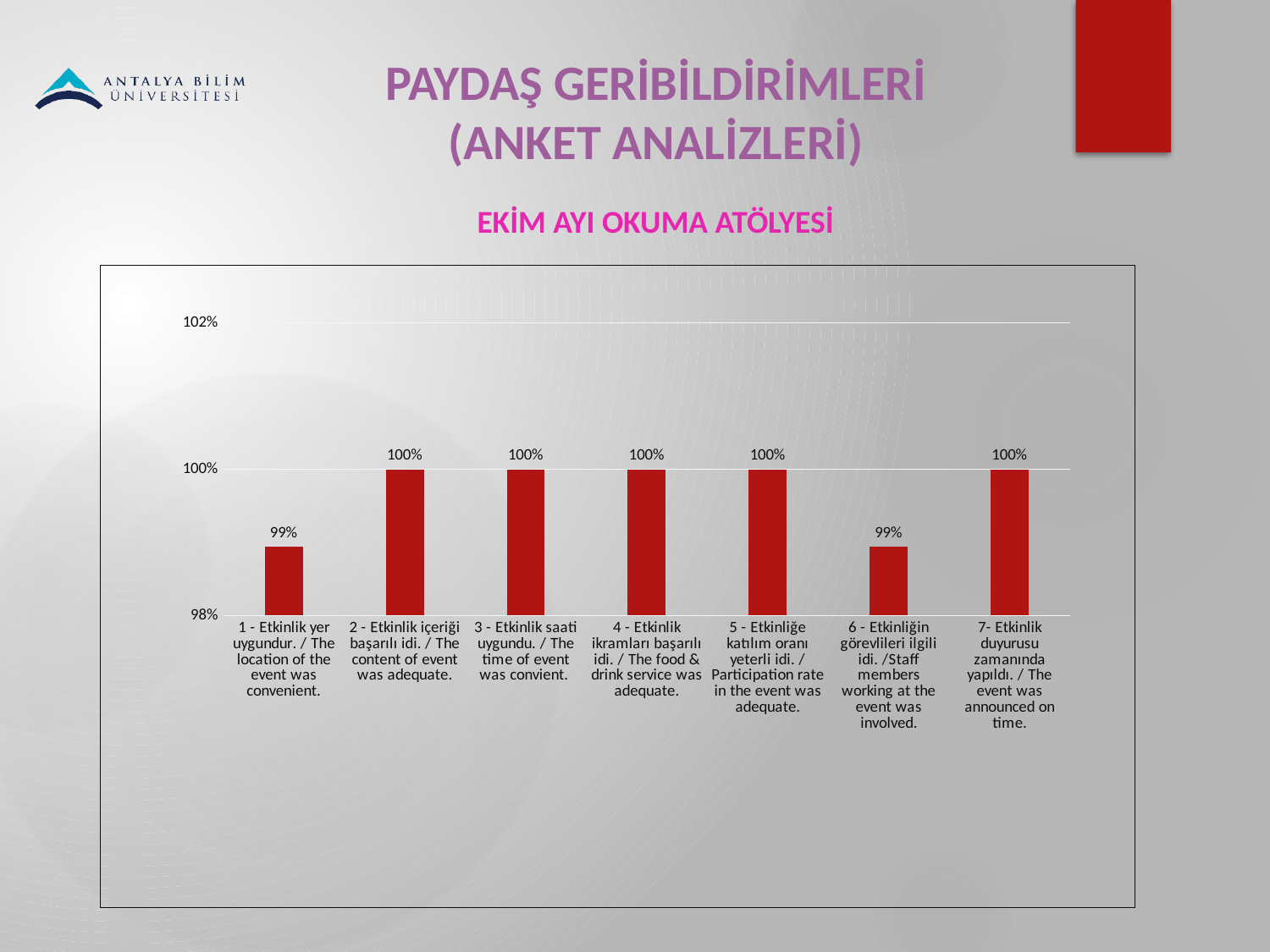
What kind of chart is shown on the slide? Bar chart What is the value for category 4 (The food & drink service was adequate)? 100% Which categories have the lowest value? 1 and 6 What is the difference between the value for category 2 and the value for category 1? 1% What is the value for category 6 (Staff members working at the event was involved)? 99% What is the subtitle shown above the chart? EKİM AYI OKUMA ATÖLYESİ What is the value for category 1 (The location of the event was convenient)? 99% How many categories have a value of 100%? 5 What colour are the bars in the chart? Red Which is larger, the value for category 3 or the value for category 6? Category 3 What is the value for category 7 (The event was announced on time)? 100% How many categories are shown in the chart? 7